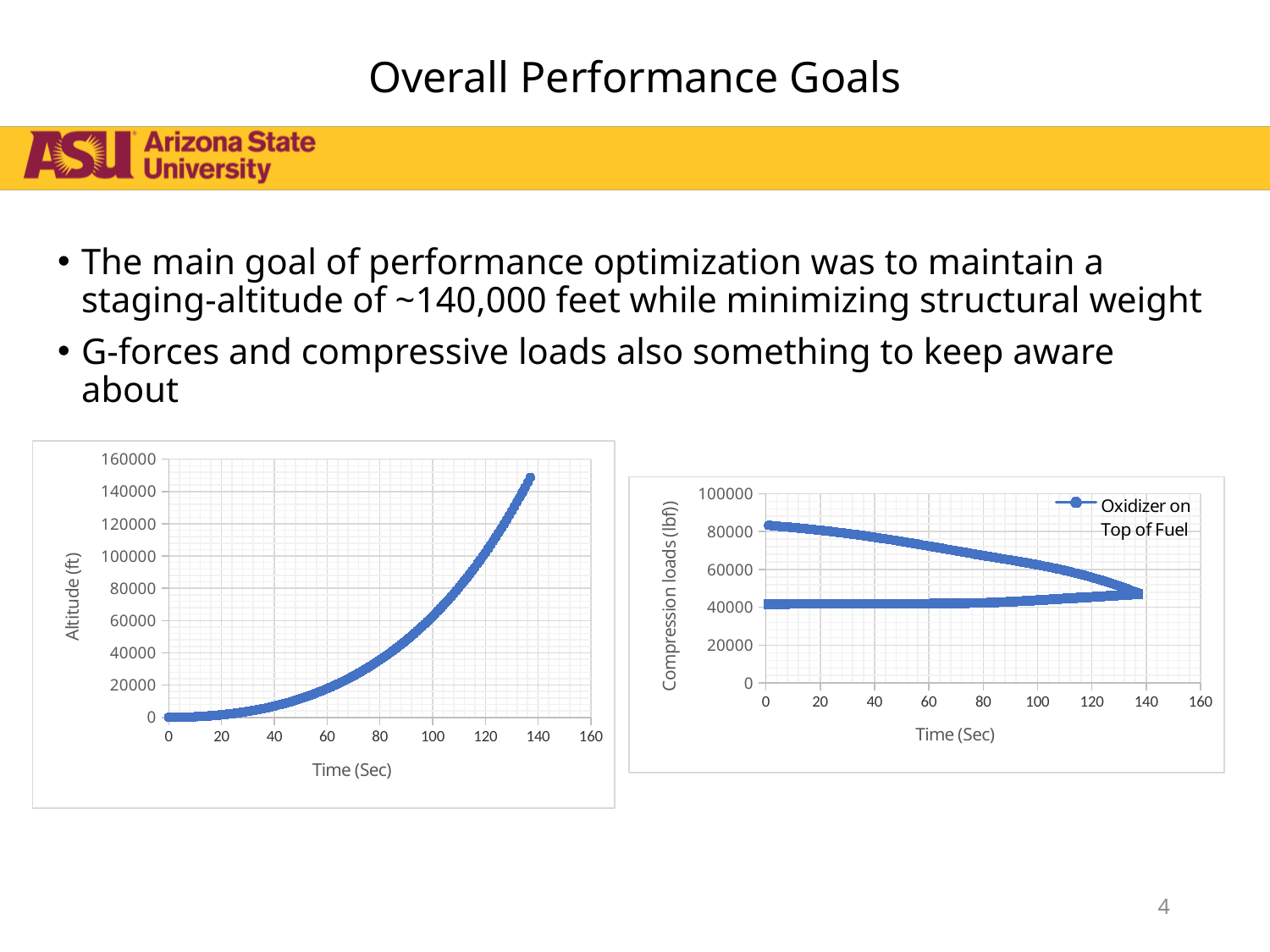
How many series does the legend of the right chart list? 1 In the right chart, is the compression load at time 0 on the upper branch greater or less than 80000? greater What is the name of the series in the legend of the right chart? Oxidizer on Top of Fuel What kind of chart is the left chart showing Altitude (ft) against Time (Sec)? line chart What is the y-axis label of the left chart? Altitude (ft) In the right chart, is the compression load at time 0 on the lower branch greater or less than 60000? less In the right chart, does the upper branch of compression loads rise or fall as time increases? fall In the left chart, is the altitude at 100 seconds greater or less than 100000? less What is the highest tick value shown on the x axis of the right chart? 160 In the left chart, does the altitude rise or fall as time increases? rise